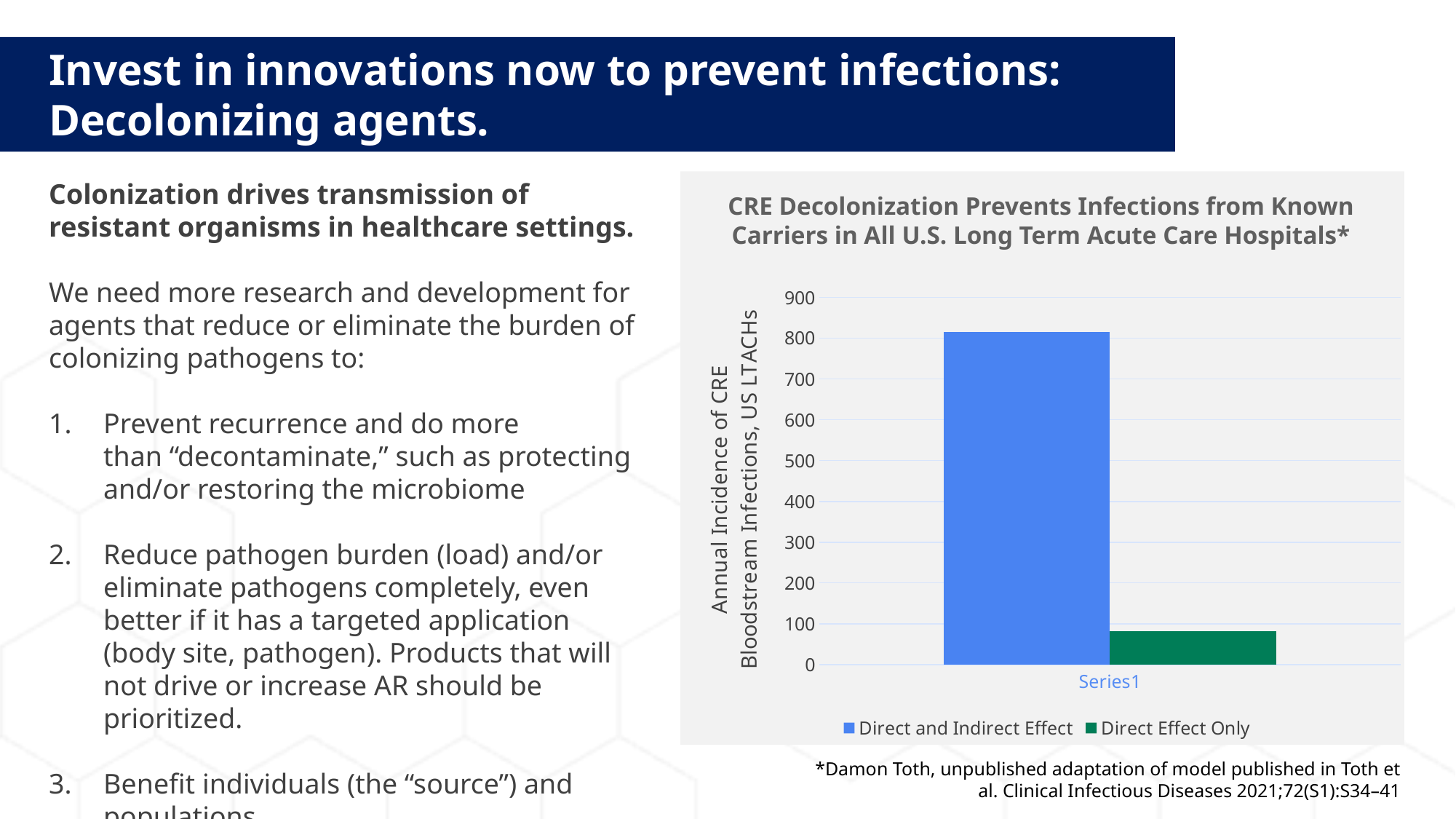
What kind of chart is shown on the slide? bar chart Which series has the highest value in the chart? Direct and Indirect Effect Is the value for Direct and Indirect Effect greater or less than 500? greater Is the value for Direct and Indirect Effect greater or less than 700? greater What is the title of the chart? CRE Decolonization Prevents Infections from Known Carriers in All U.S. Long Term Acute Care Hospitals* How many categories are shown on the x axis of the chart? 1 Which series has the higher value, Direct and Indirect Effect or Direct Effect Only? Direct and Indirect Effect Is the value for Direct Effect Only greater or less than 100? less What colour is the bar for Direct Effect Only? green How many series does the chart legend list? 2 Which series has the lowest value in the chart? Direct Effect Only